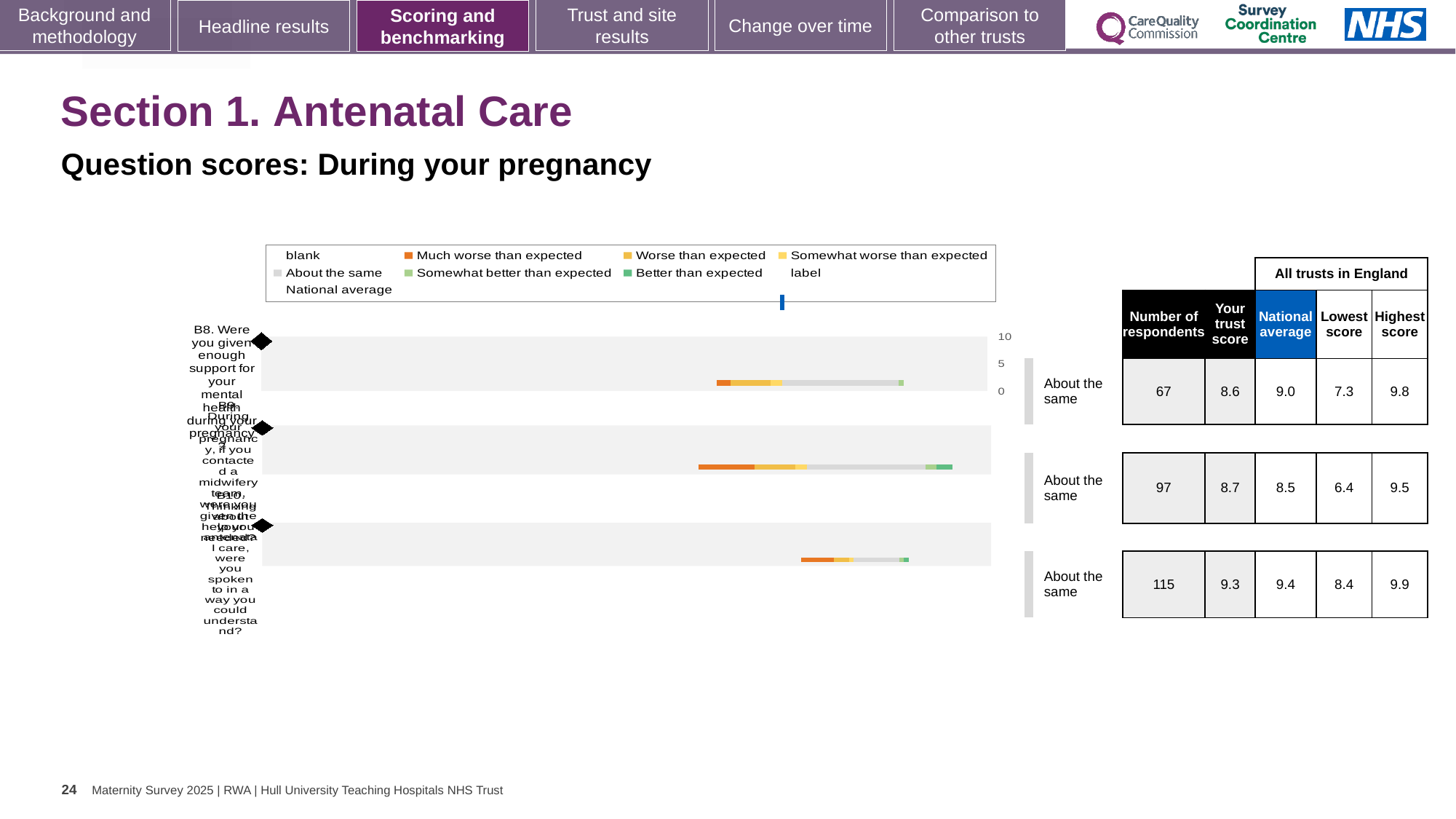
How many entries does the chart legend list? 9 For question B9, which is larger: the trust score or the national average? trust score For question B8, what is the difference between the highest score (9.8) and the lowest score (7.3) in the table? 2.5 In the table beside the chart, what is the number of respondents for question B8 (support for your mental health during pregnancy)? 67 How many survey questions (categories) are plotted in the chart? 3 In the table beside the chart, what is the trust score for question B10 (spoken to in a way you could understand)? 9.3 Which legend entry is shown in dark orange? Much worse than expected Which question has the highest number of respondents in the table beside the chart? B10 What is the benchmark category shown next to each bar in the chart? About the same In the table beside the chart, what is the national average for question B9 (help from a midwifery team)? 8.5 Which question has the lowest 'Lowest score' in the table beside the chart? B9 What kind of chart is shown on the slide? bar chart